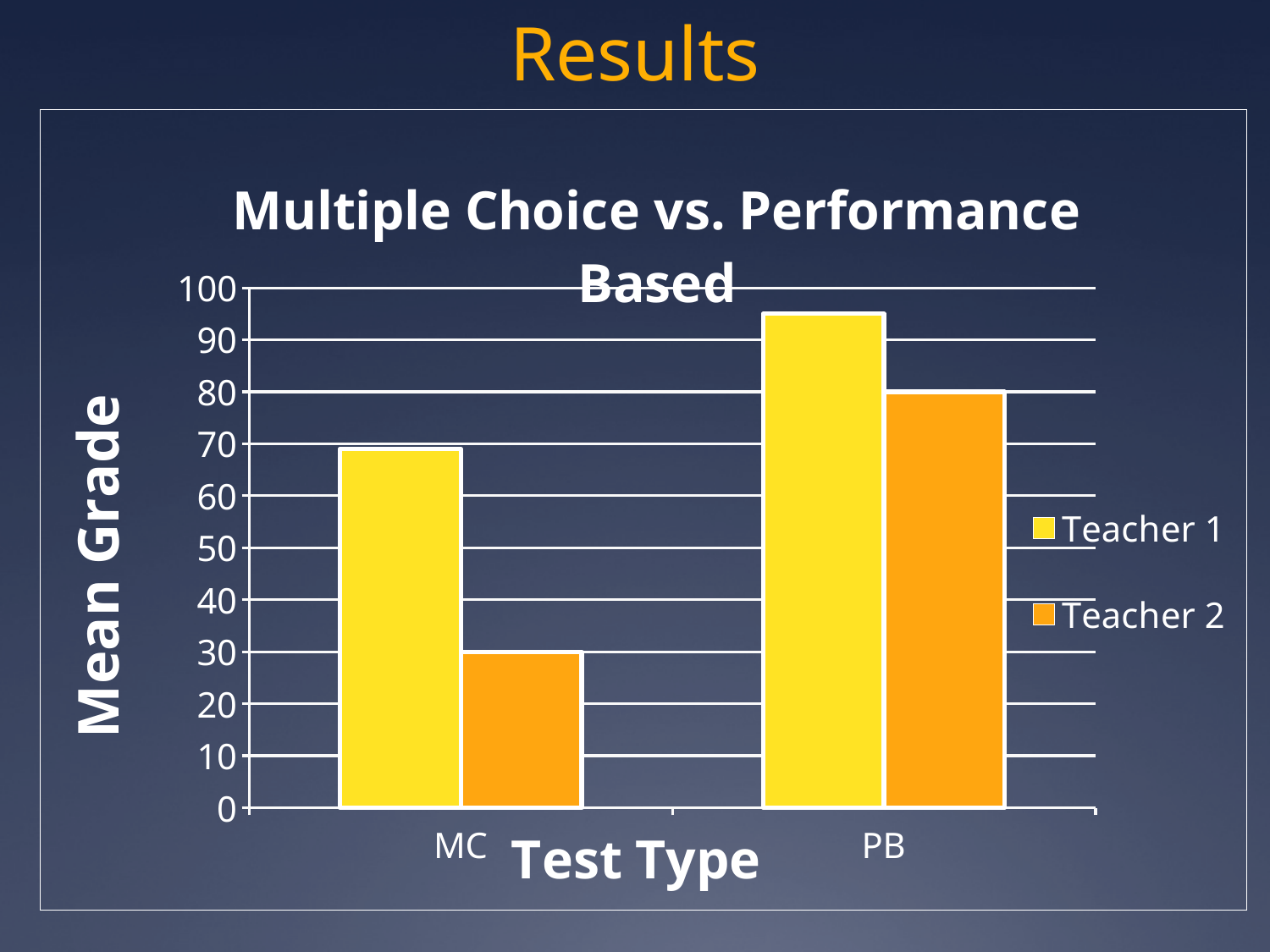
Which test type has the lowest mean grade for Teacher 2? MC Which series has the higher mean grade for MC? Teacher 1 Which test type has the highest mean grade for Teacher 1? PB What kind of chart is shown on the slide? bar chart What is the label of the y axis? Mean Grade Which series has the higher mean grade for PB? Teacher 1 Is the mean grade for Teacher 1 on PB greater or less than 90? greater How many test type categories are shown on the x axis? 2 Is the mean grade for Teacher 1 on MC greater or less than 60? greater Is the mean grade for Teacher 2 on MC greater or less than 40? less What is the title of the chart? Multiple Choice vs. Performance Based How many series does the legend list? 2